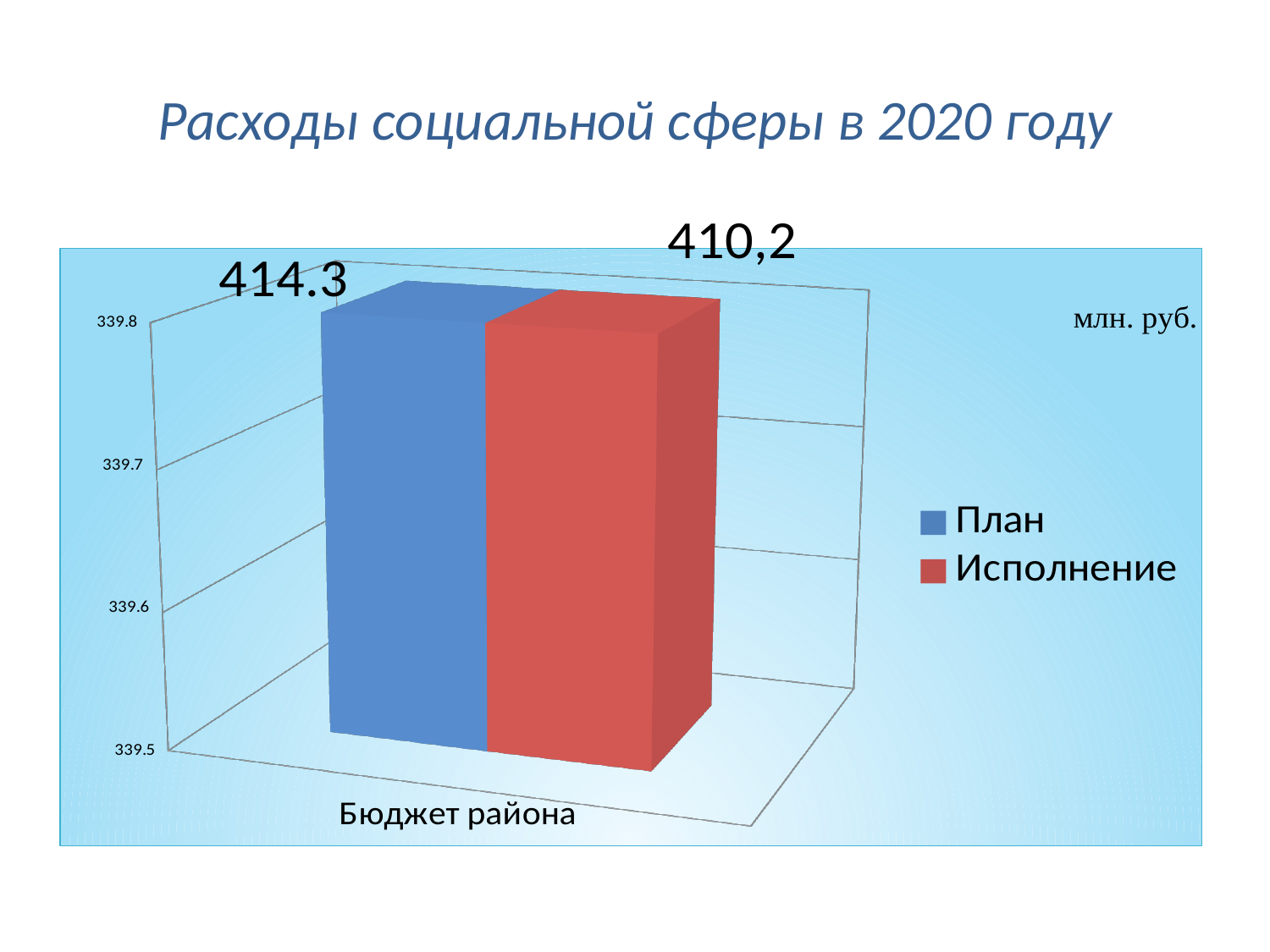
What is the value for План (Plan) for Бюджет района? 414.3 How many series does the legend list? 2 What kind of chart is shown on the slide? bar chart Which series shows the lowest value on the chart? Исполнение Which series has the higher value for Бюджет района, План or Исполнение? План What is the value for Исполнение (Execution) for Бюджет района? 410,2 What unit of measurement is indicated on the chart? млн. руб. Which series shows the highest value on the chart? План What is the title of the slide? Расходы социальной сферы в 2020 году How many categories are shown on the x axis of the chart? 1 What is the difference between the План value and the Исполнение value? 4.1